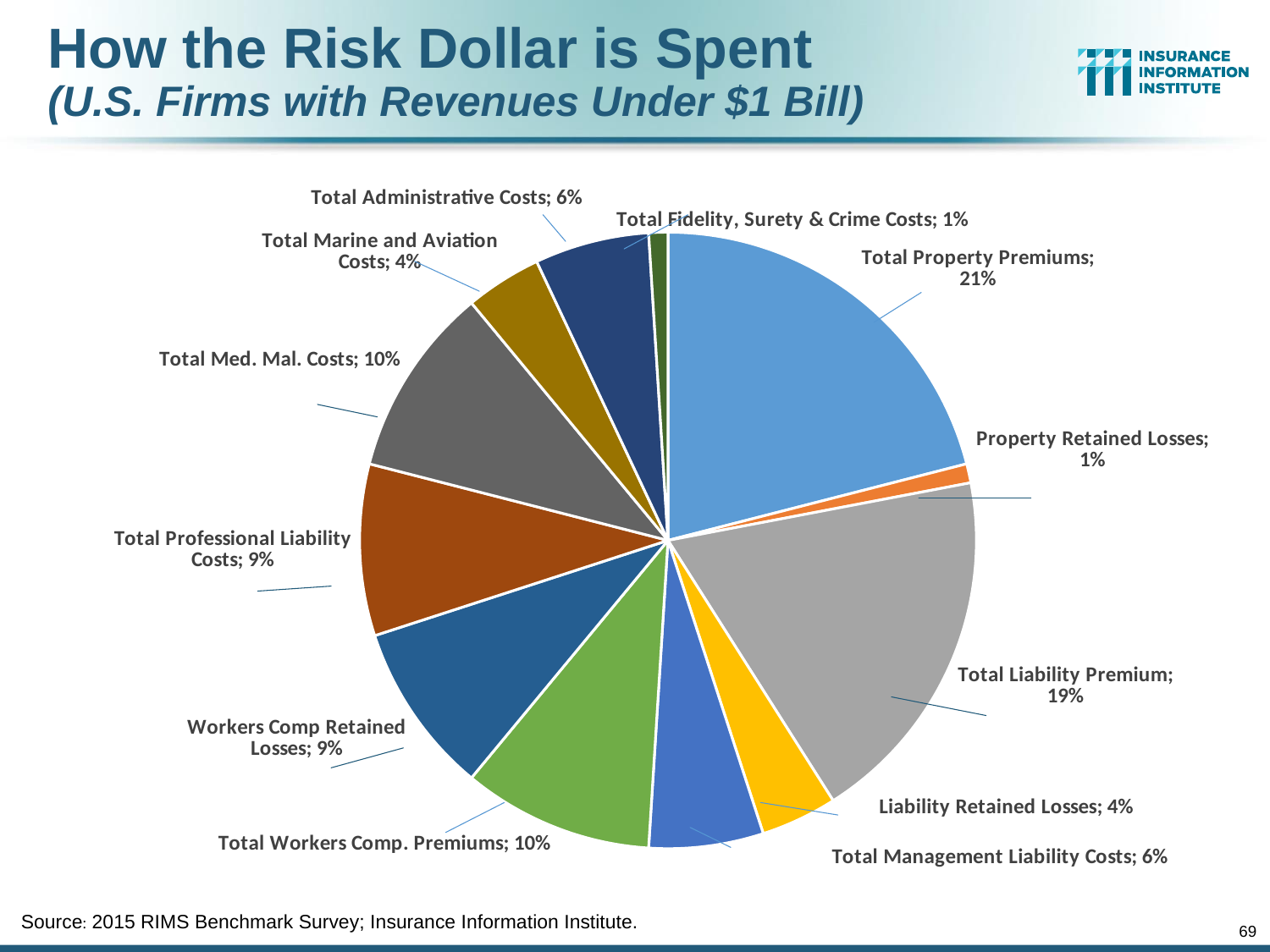
What is the title of the chart on the slide? How the Risk Dollar is Spent (U.S. Firms with Revenues Under $1 Bill) Which category has the largest slice of the pie? Total Property Premiums What is the difference between Total Property Premiums and Total Liability Premium? 2% Which is larger, Total Med. Mal. Costs or Total Professional Liability Costs? Total Med. Mal. Costs What percentage is labelled for Total Marine and Aviation Costs? 4% What kind of chart is shown on the slide? Pie chart How many slices does the pie chart have? 12 What share of the risk dollar goes to Total Property Premiums? 21% What percentage is shown for Total Liability Premium? 19% What share is shown for Total Fidelity, Surety & Crime Costs? 1% What is the value for Total Med. Mal. Costs? 10% What share of the pie does Workers Comp Retained Losses represent? 9%